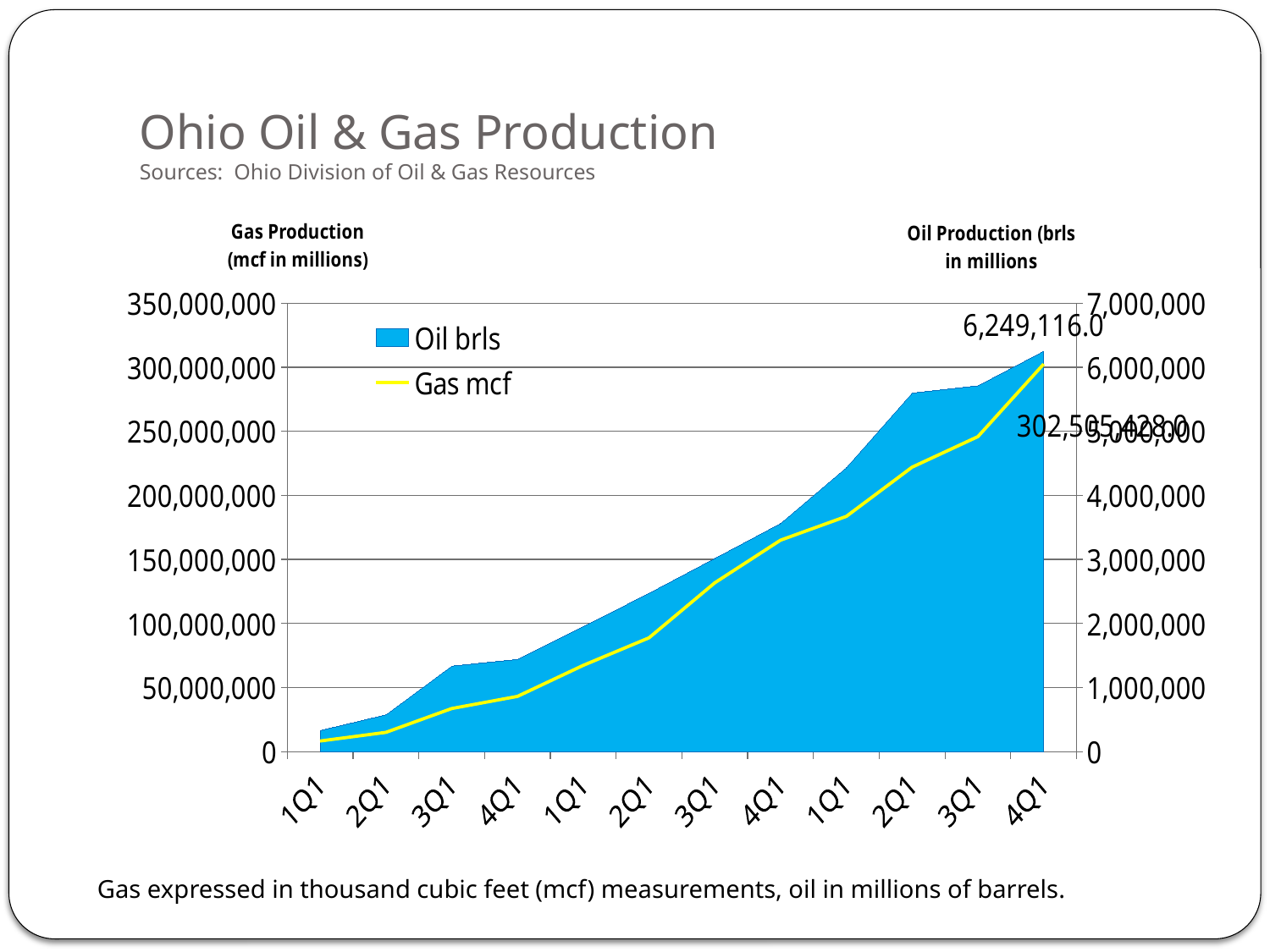
What is the Oil brls value labelled at the final 4Q1 point? 6,249,116.0 How many series does the chart legend list? 2 Is the Gas mcf value at the first 1Q1 point greater or less than 50,000,000? less Is the Oil brls value at the first 1Q1 point greater or less than 1,000,000? less Do the Oil brls values generally rise or fall from left to right along the x axis? Rise Is the Gas mcf value at the final 4Q1 point greater or less than 250,000,000? greater What kind of chart is shown on the slide? A combined area and line chart At which point along the x axis does Oil brls reach its highest value? The final 4Q1 (rightmost point) What are the two series named in the chart legend? Oil brls and Gas mcf Do the Gas mcf values generally rise or fall across the quarters shown? Rise What is the title of the left-hand vertical axis? Gas Production (mcf in millions) How many quarterly points are plotted along the x axis? 12